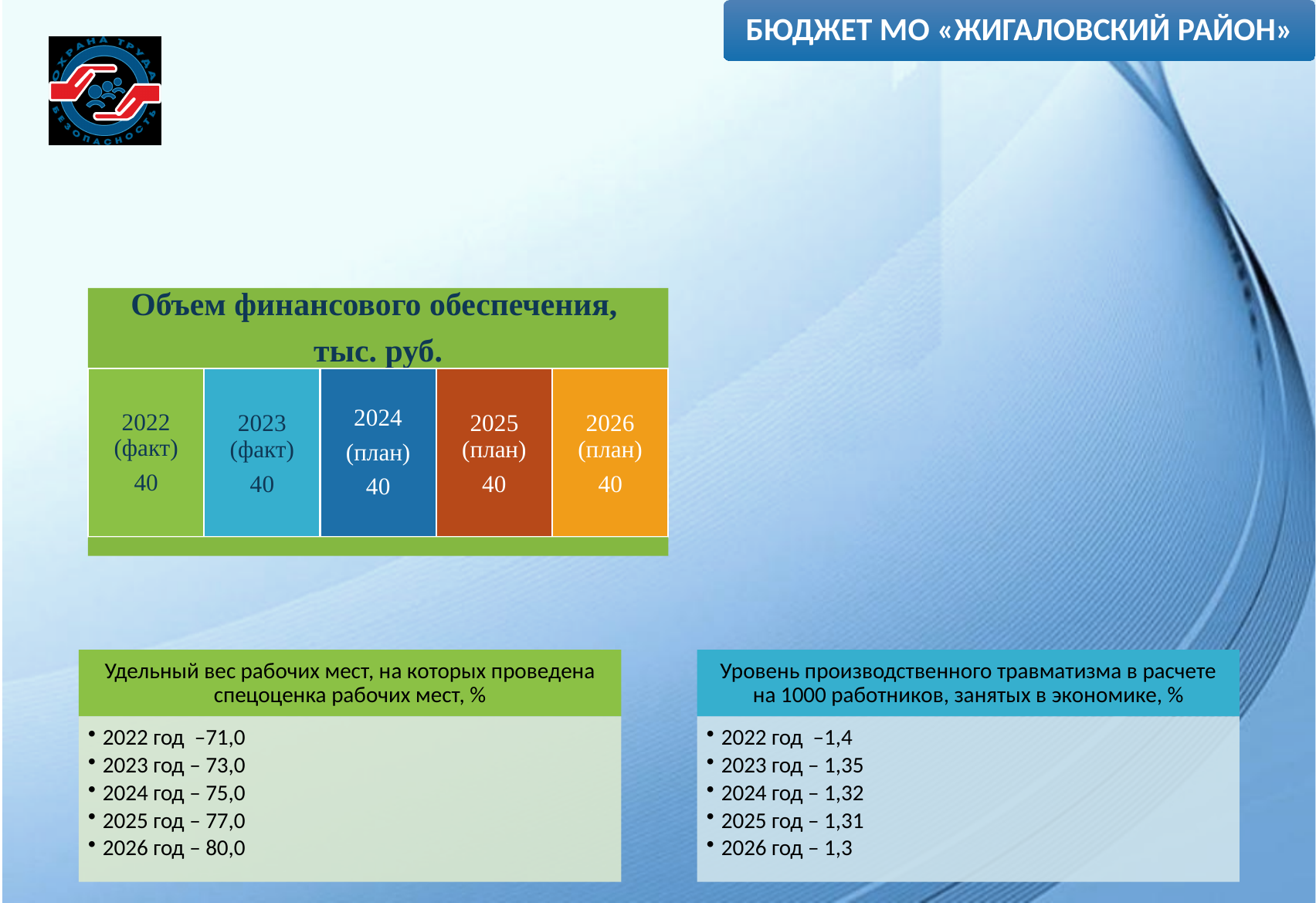
In the chart 'Объем финансового обеспечения, тыс. руб.', what is the value for 2026 (план)? 40 In the chart 'Объем финансового обеспечения, тыс. руб.', is the value for 2023 (факт) greater or less than 50? less In the chart 'Объем финансового обеспечения, тыс. руб.', do the values rise, fall or stay the same from 2022 to 2026? stay the same What is the title of the chart on the slide? Объем финансового обеспечения, тыс. руб. In the chart 'Объем финансового обеспечения, тыс. руб.', what is the difference between the values for 2025 (план) and 2023 (факт)? 0 What kind of chart is 'Объем финансового обеспечения, тыс. руб.'? table In the chart 'Объем финансового обеспечения, тыс. руб.', which years are marked as 'факт'? 2022 and 2023 In the chart 'Объем финансового обеспечения, тыс. руб.', what is the value for 2022 (факт)? 40 In the chart 'Объем финансового обеспечения, тыс. руб.', what is the value for 2024 (план)? 40 How many categories (years) are shown in the chart 'Объем финансового обеспечения, тыс. руб.'? 5